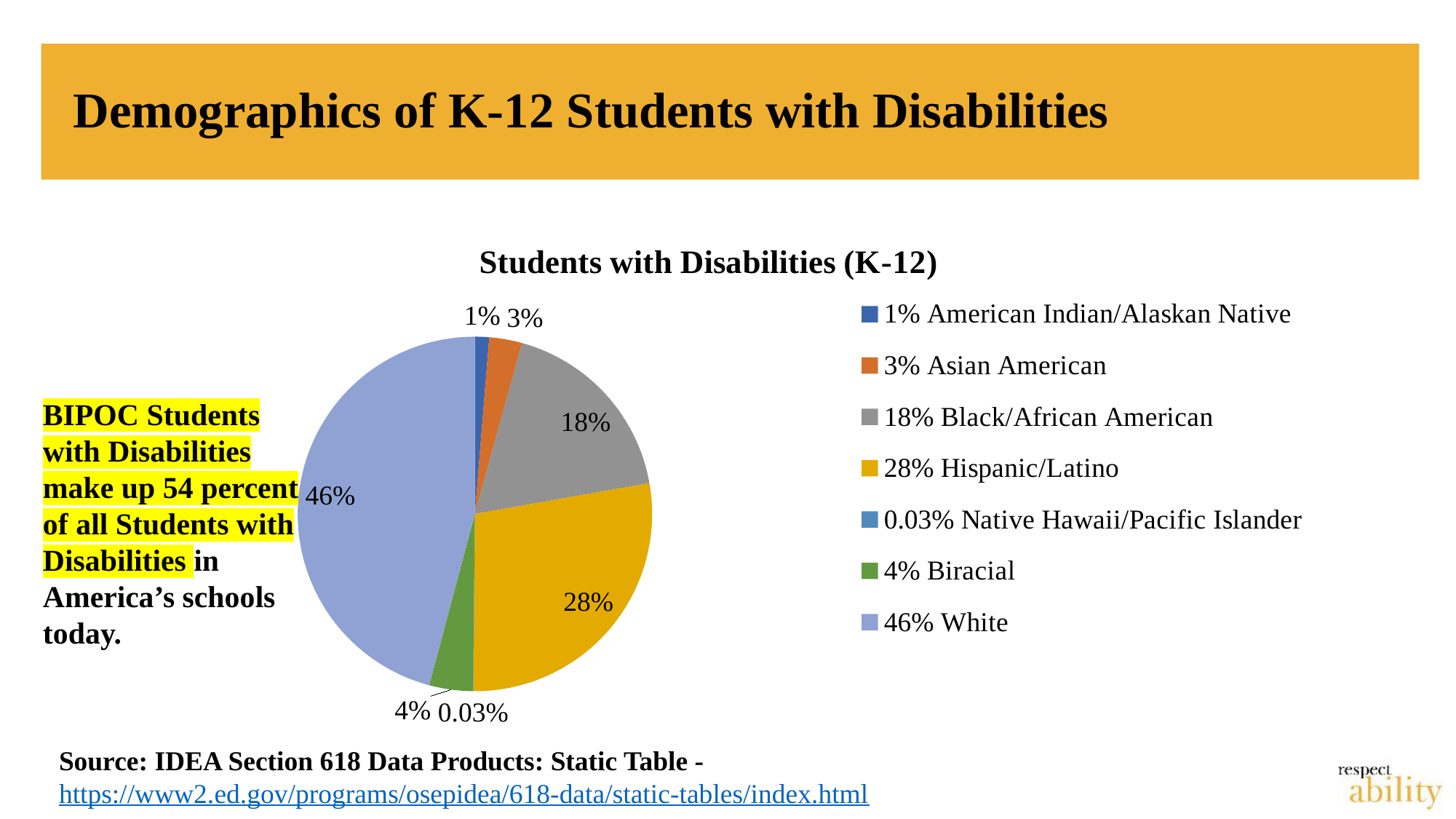
Which group has the smallest share of the pie? Native Hawaii/Pacific Islander What percentage of students with disabilities are Black/African American? 18% What type of chart is shown on the slide? pie chart What colour is the slice for Hispanic/Latino? yellow/gold How many categories does the legend list? 7 What is the title of the chart? Students with Disabilities (K-12) Which group has the largest share of the pie? White Which is larger, the share for Biracial or the share for Asian American? Biracial What percentage of students with disabilities are White? 46% What percentage of students with disabilities are Native Hawaii/Pacific Islander? 0.03% What is the difference between the White share and the Hispanic/Latino share? 18% What percentage of students with disabilities are Hispanic/Latino? 28%